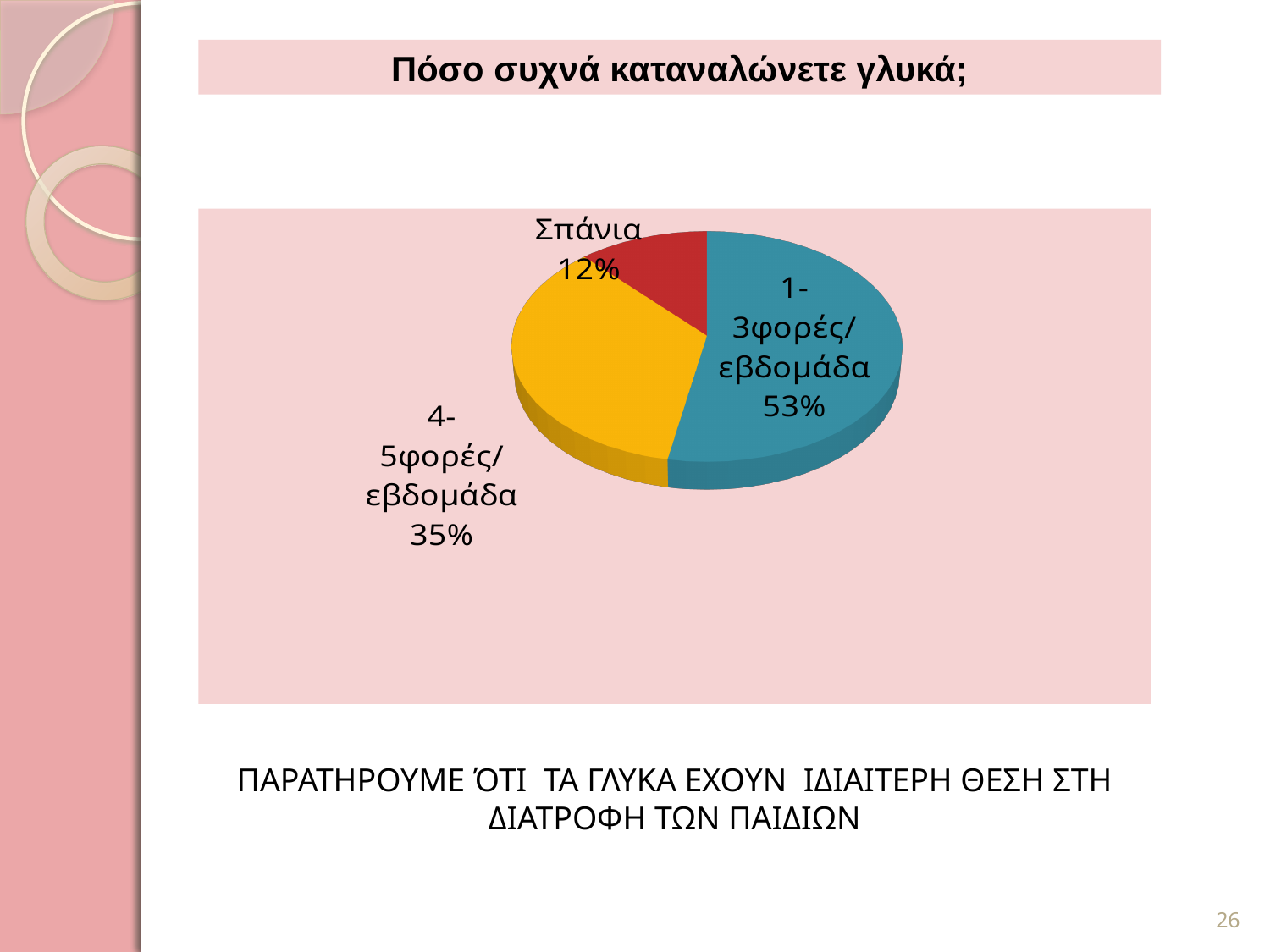
What kind of chart is shown on the slide? pie chart What is the difference in percentage points between the "1-3φορές/εβδομάδα" slice and the "4-5φορές/εβδομάδα" slice? 18% Which category has the smallest slice of the pie? Σπάνια What is the difference in percentage points between the "4-5φορές/εβδομάδα" slice and the "Σπάνια" slice? 23% Which is larger: the "4-5φορές/εβδομάδα" slice or the "Σπάνια" slice? 4-5φορές/εβδομάδα What share of the pie does the "4-5φορές/εβδομάδα" slice represent? 35% What colour is the "Σπάνια" slice of the pie? red What share of the pie does the "1-3φορές/εβδομάδα" slice represent? 53% Which category has the largest slice of the pie? 1-3φορές/εβδομάδα What is the title of the question shown above the chart? Πόσο συχνά καταναλώνετε γλυκά; What share of the pie does the "Σπάνια" slice represent? 12% How many slices does the pie chart have? 3